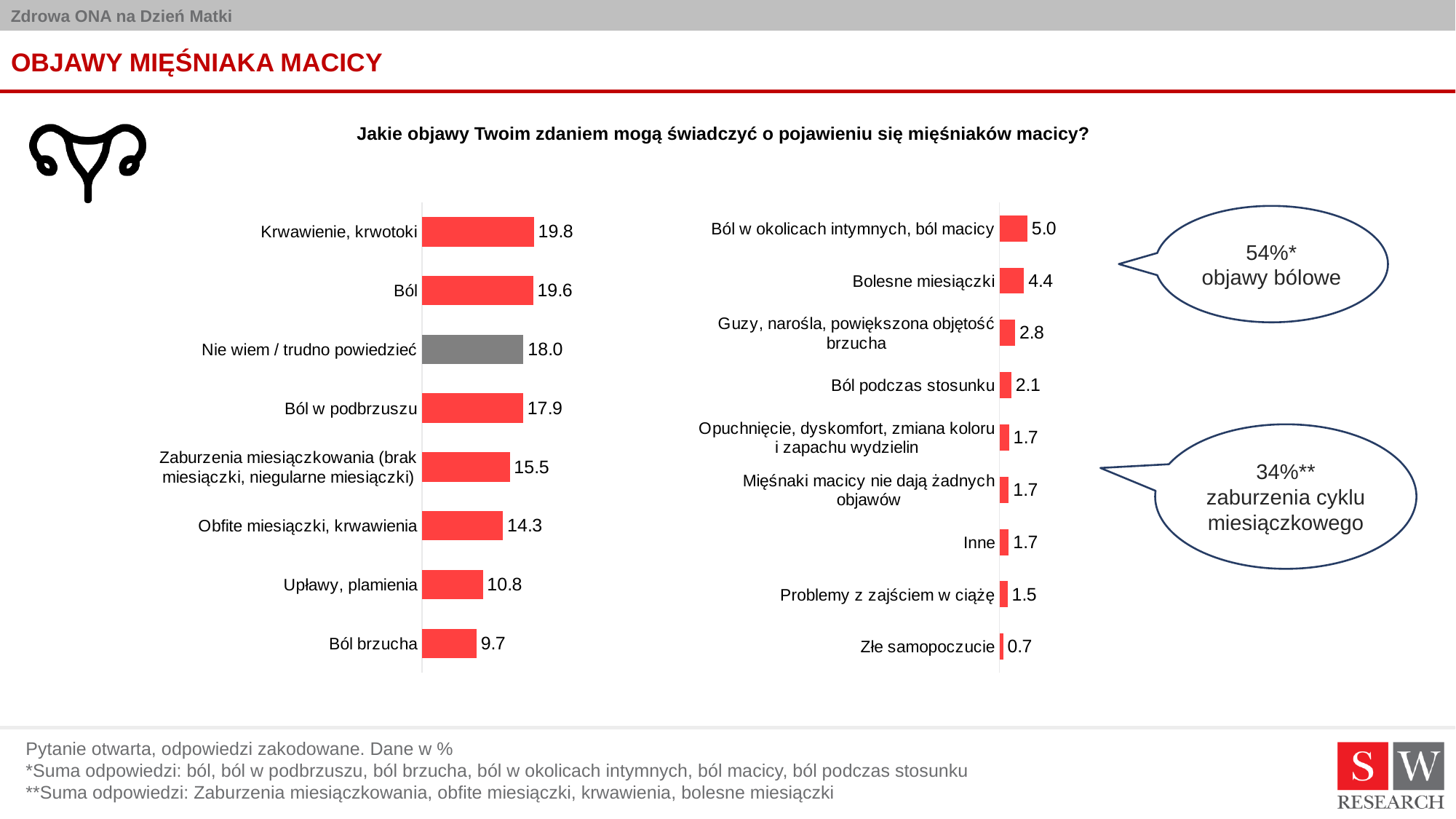
In the left chart, what is the difference between "Krwawienie, krwotoki" and "Ból brzucha"? 10.1 In the right chart, which category has the highest value? Ból w okolicach intymnych, ból macicy In the right chart, which category has the lowest value? Złe samopoczucie In the left chart, what is the value for "Krwawienie, krwotoki"? 19.8 How many categories are shown in the left chart? 8 How many categories are shown in the right chart? 9 In the left chart, which category has the lowest value? Ból brzucha In the left chart, which is larger: "Obfite miesiączki, krwawienia" or "Zaburzenia miesiączkowania (brak miesiączki, niegularne miesiączki)"? Zaburzenia miesiączkowania (brak miesiączki, niegularne miesiączki) In the right chart, what is the difference between "Ból w okolicach intymnych, ból macicy" and "Ból podczas stosunku"? 2.9 In the left chart, which bar is coloured grey instead of red? Nie wiem / trudno powiedzieć In the right chart, what is the value for "Bolesne miesiączki"? 4.4 In the left chart, what is the value for "Upławy, plamienia"? 10.8